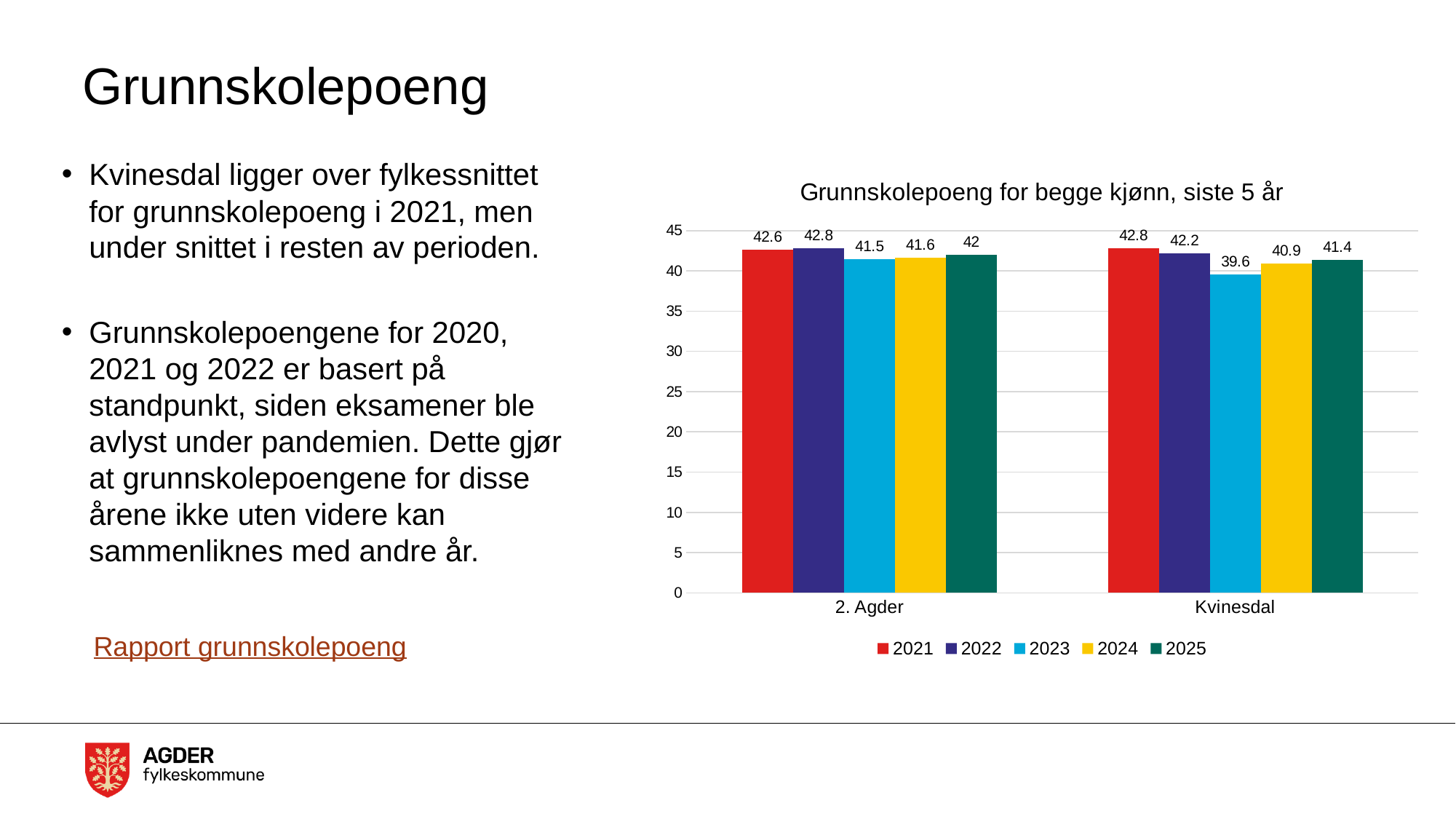
How many categories are shown on the x axis? 2 Which year has the highest value for 2. Agder? 2022 How many series does the legend list? 5 What kind of chart is shown on the slide? Bar chart Which is larger, the 2022 value for 2. Agder or the 2022 value for Kvinesdal? 2. Agder Which year has the lowest value for Kvinesdal? 2023 What is the value for 2. Agder in 2021? 42.6 What is the title of the chart? Grunnskolepoeng for begge kjønn, siste 5 år What is the value for Kvinesdal in 2023? 39.6 What is the difference between the 2. Agder and Kvinesdal values in 2023? 1.9 What is the value for Kvinesdal in 2025? 41.4 What is the value for 2. Agder in 2024? 41.6